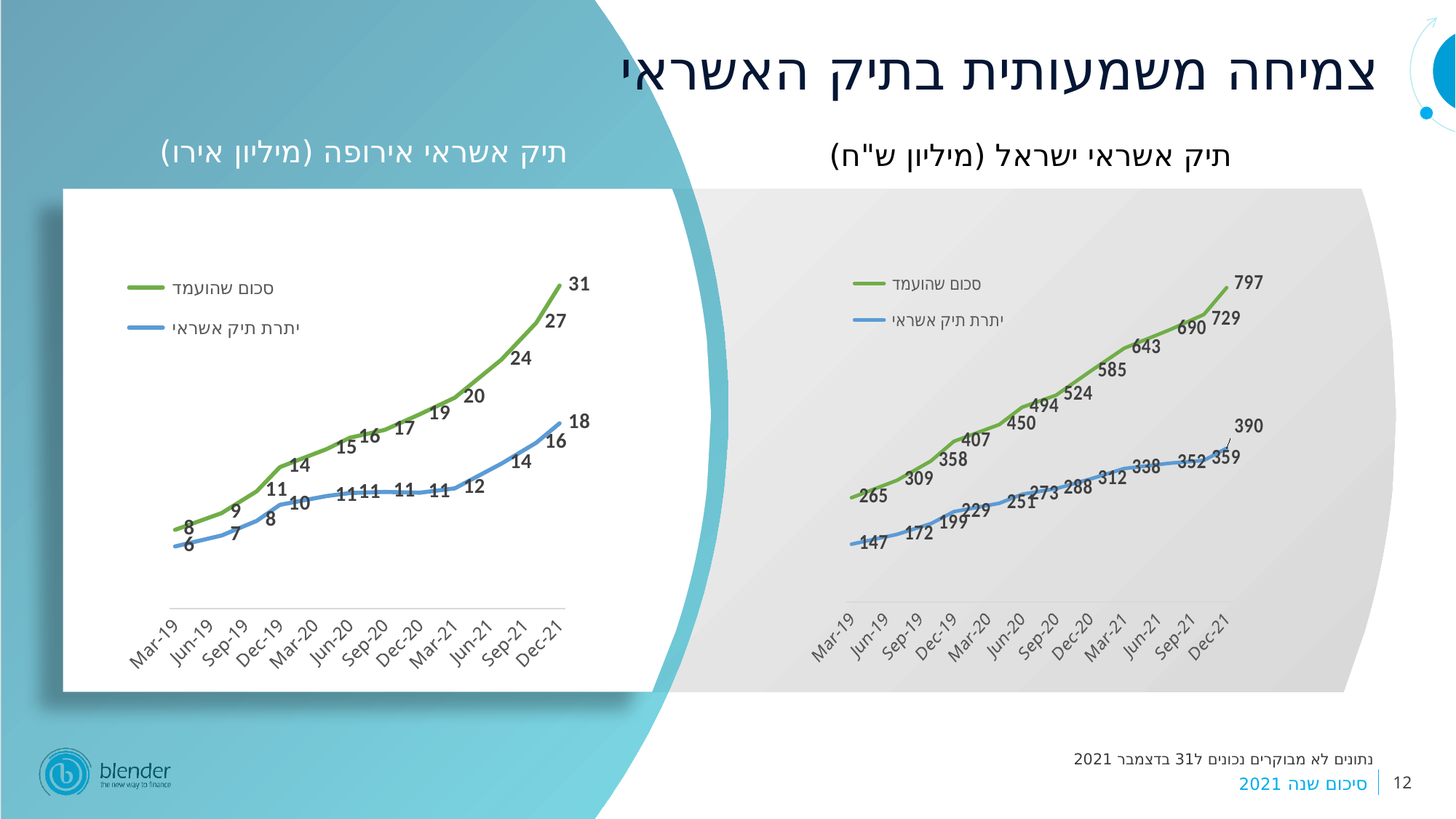
On the left chart (תיק אשראי אירופה), what is the value of the green series (סכום שהועמד) at Dec-21? 31 On the right chart (תיק אשראי ישראל), at which date is the blue series (יתרת תיק אשראי) highest? Dec-21 How many series does the legend of the left chart (תיק אשראי אירופה) list? 2 On the left chart (תיק אשראי אירופה), what is the difference between the green series value at Dec-21 and the green series value at Mar-19? 23 On the right chart (תיק אשראי ישראל), what is the value of the green series (סכום שהועמד) at Dec-21? 797 On the right chart (תיק אשראי ישראל), how many dates are shown on the x axis? 12 On the right chart (תיק אשראי ישראל), what is the difference between the green series value at Dec-21 and the blue series value at Dec-21? 407 What kind of chart is the right chart (תיק אשראי ישראל)? line chart On the right chart (תיק אשראי ישראל), what is the value of the blue series (יתרת תיק אשראי) at Mar-19? 147 On the left chart (תיק אשראי אירופה), does the green series rise or fall from Mar-19 to Dec-21? rise On the left chart (תיק אשראי אירופה), which is larger at Sep-21: the green series or the blue series? the green series (סכום שהועמד) On the left chart (תיק אשראי אירופה), what is the value of the blue series (יתרת תיק אשראי) at Mar-19? 6